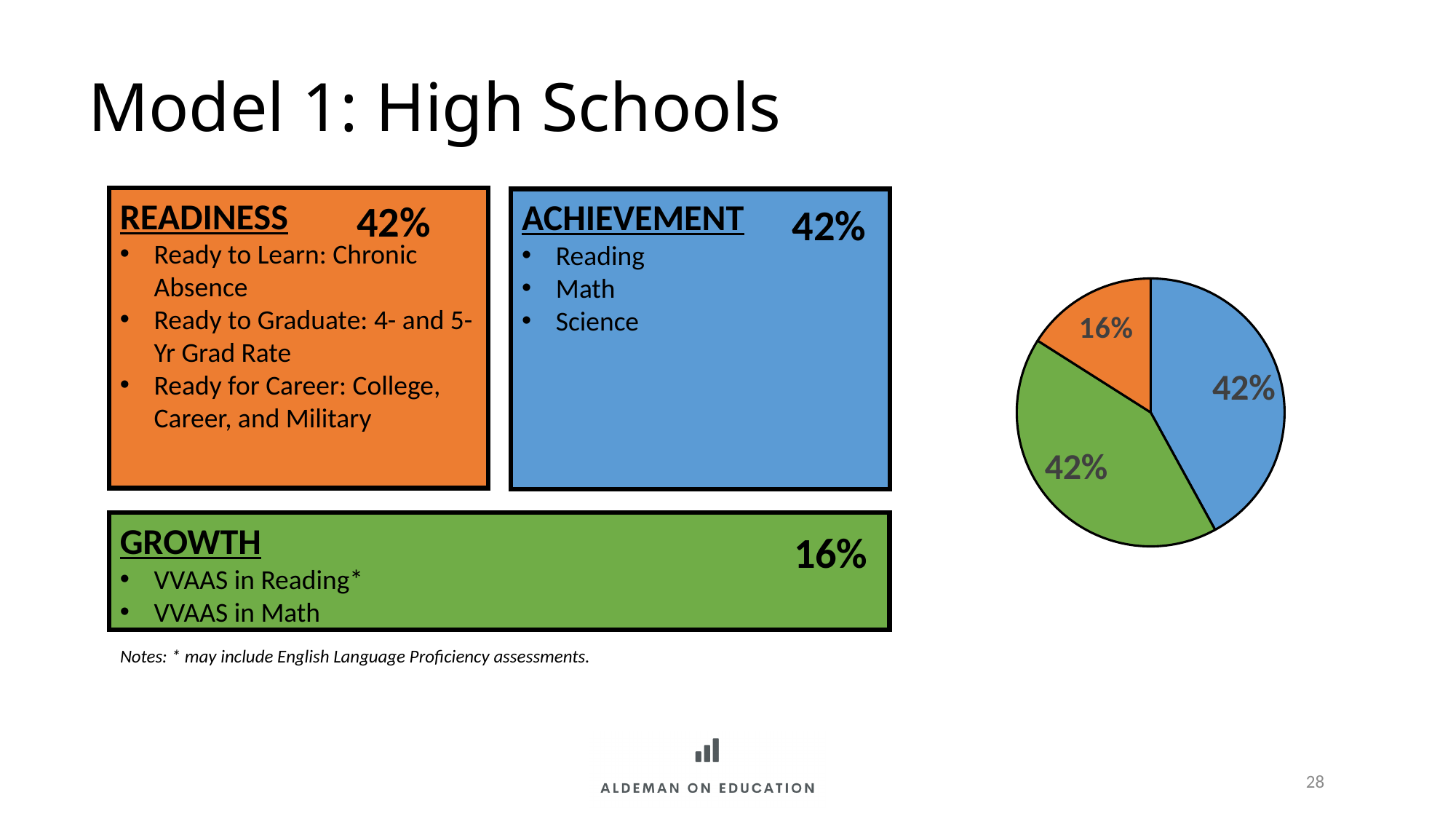
Which colour in the pie chart matches the READINESS box on the slide? orange What percentage is shown on the orange slice of the pie chart? 16% Is the blue slice of the pie chart larger or smaller than the orange slice? larger What kind of chart is shown on the right side of the slide? pie chart What is the difference between the green slice and the orange slice of the pie chart? 26% What percentage is shown on the green slice of the pie chart? 42% Which slice of the pie chart is the smallest? the orange slice (16%) What is the combined share of the blue and green slices of the pie chart? 84% What percentage is shown on the blue slice of the pie chart? 42% How many slices does the pie chart have? 3 Do the blue and green slices of the pie chart have the same percentage? yes, both 42% Which colour in the pie chart matches the GROWTH box on the slide? green